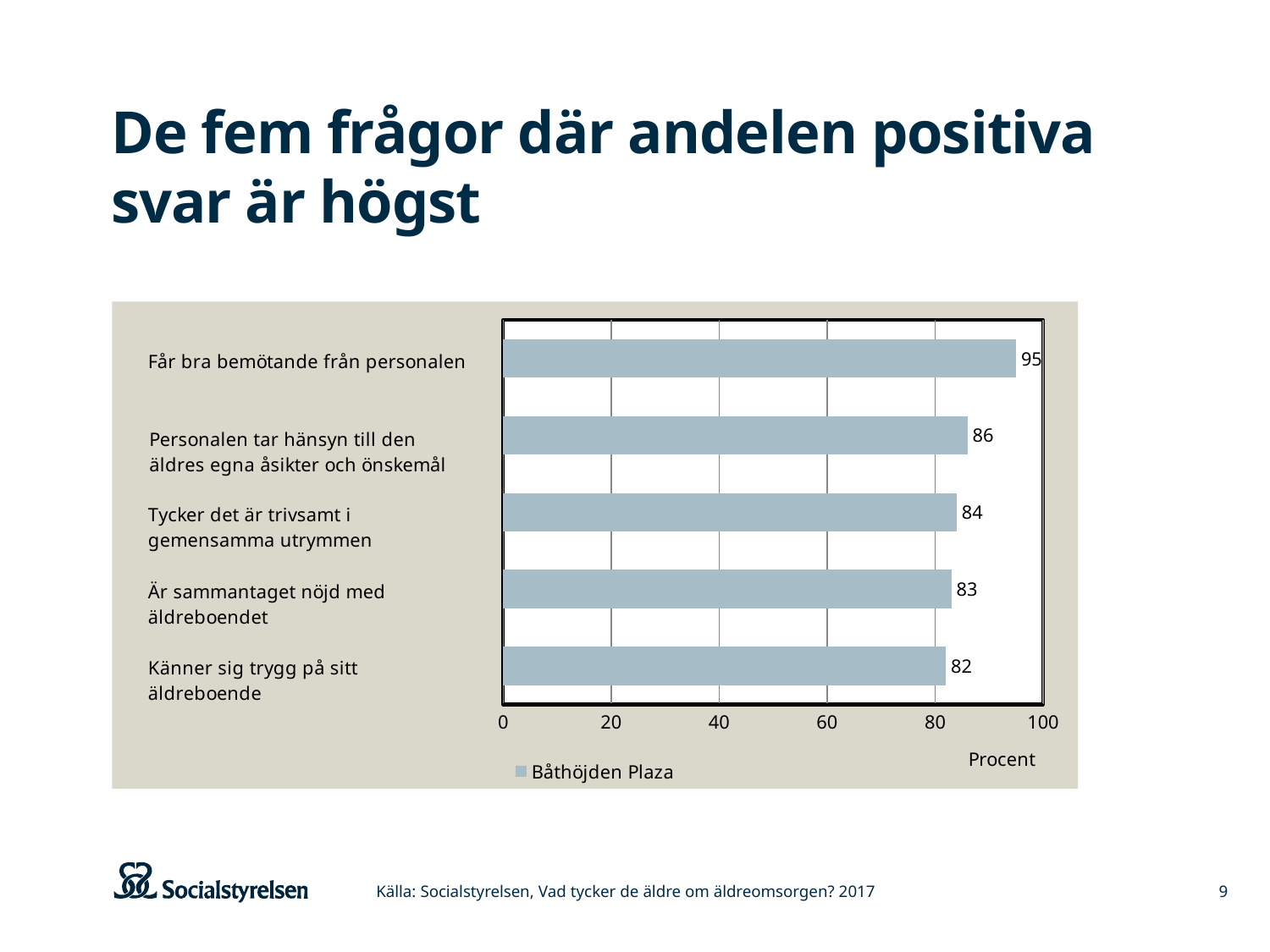
Is the value for "Är sammantaget nöjd med äldreboendet" greater or less than 80? greater Which is larger: the value for "Personalen tar hänsyn till den äldres egna åsikter och önskemål" or the value for "Är sammantaget nöjd med äldreboendet"? Personalen tar hänsyn till den äldres egna åsikter och önskemål How many series does the legend list? 1 What is the name of the series shown in the legend? Båthöjden Plaza What kind of chart is shown on the slide? Bar chart How many categories are shown in the chart? 5 What is the difference between the values for "Får bra bemötande från personalen" and "Känner sig trygg på sitt äldreboende"? 13 What is the value for "Känner sig trygg på sitt äldreboende"? 82 Which category has the lowest value? Känner sig trygg på sitt äldreboende What is the value for "Tycker det är trivsamt i gemensamma utrymmen"? 84 What is the value for "Får bra bemötande från personalen"? 95 Which category has the highest value? Får bra bemötande från personalen